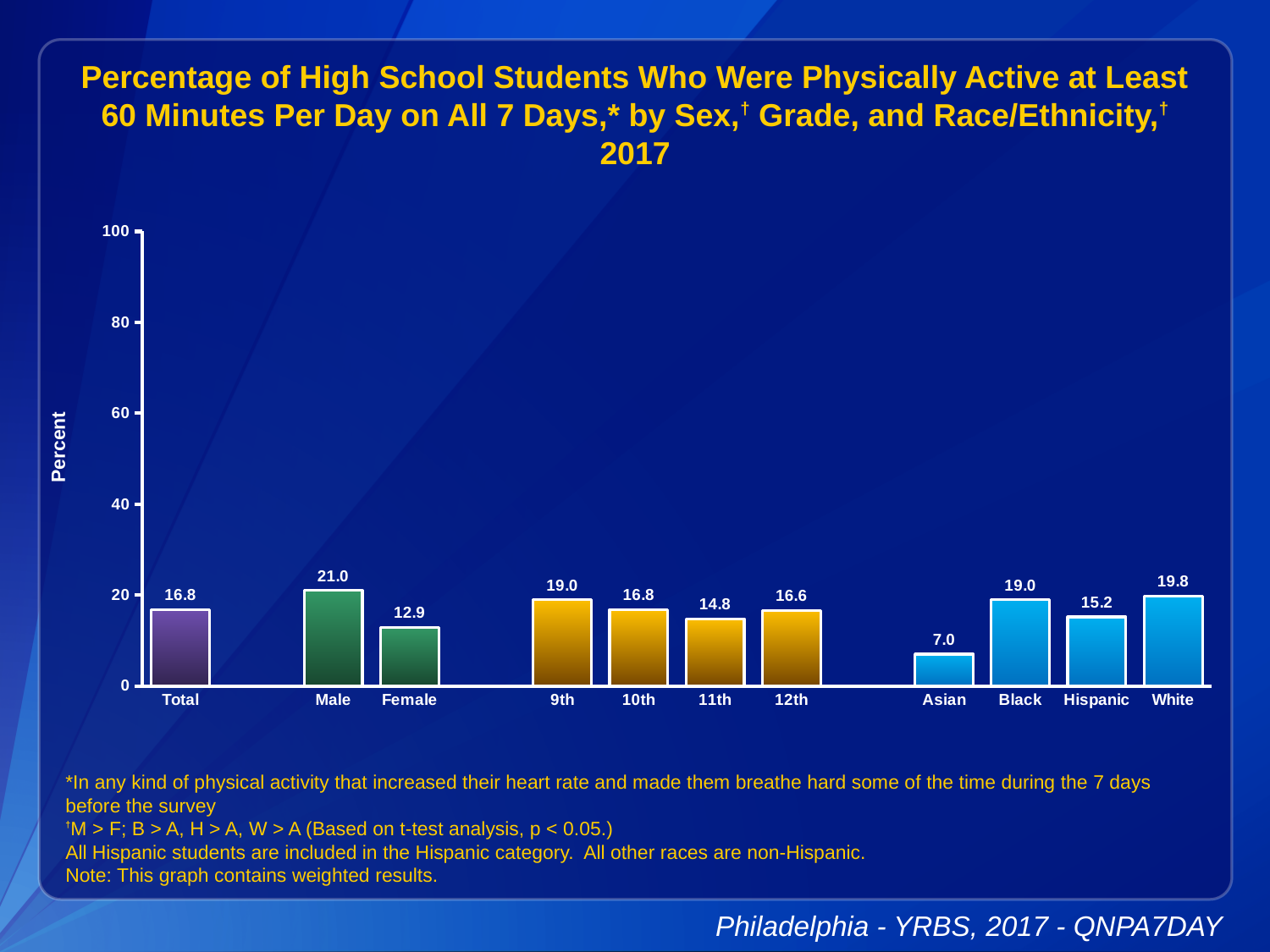
Which category has the lowest value? Asian What is the value for Asian? 7.0 What is the value for Male? 21.0 Which is larger, the value for Black or the value for Hispanic? Black Which category has the highest value? Male What is the difference between the Male and Female values? 8.1 What is the value for 11th grade? 14.8 Is the value for White greater or less than 40? less How many categories are shown on the x axis? 11 What is the difference between the 9th grade and 12th grade values? 2.4 What is the label on the y axis? Percent What kind of chart is this? bar chart